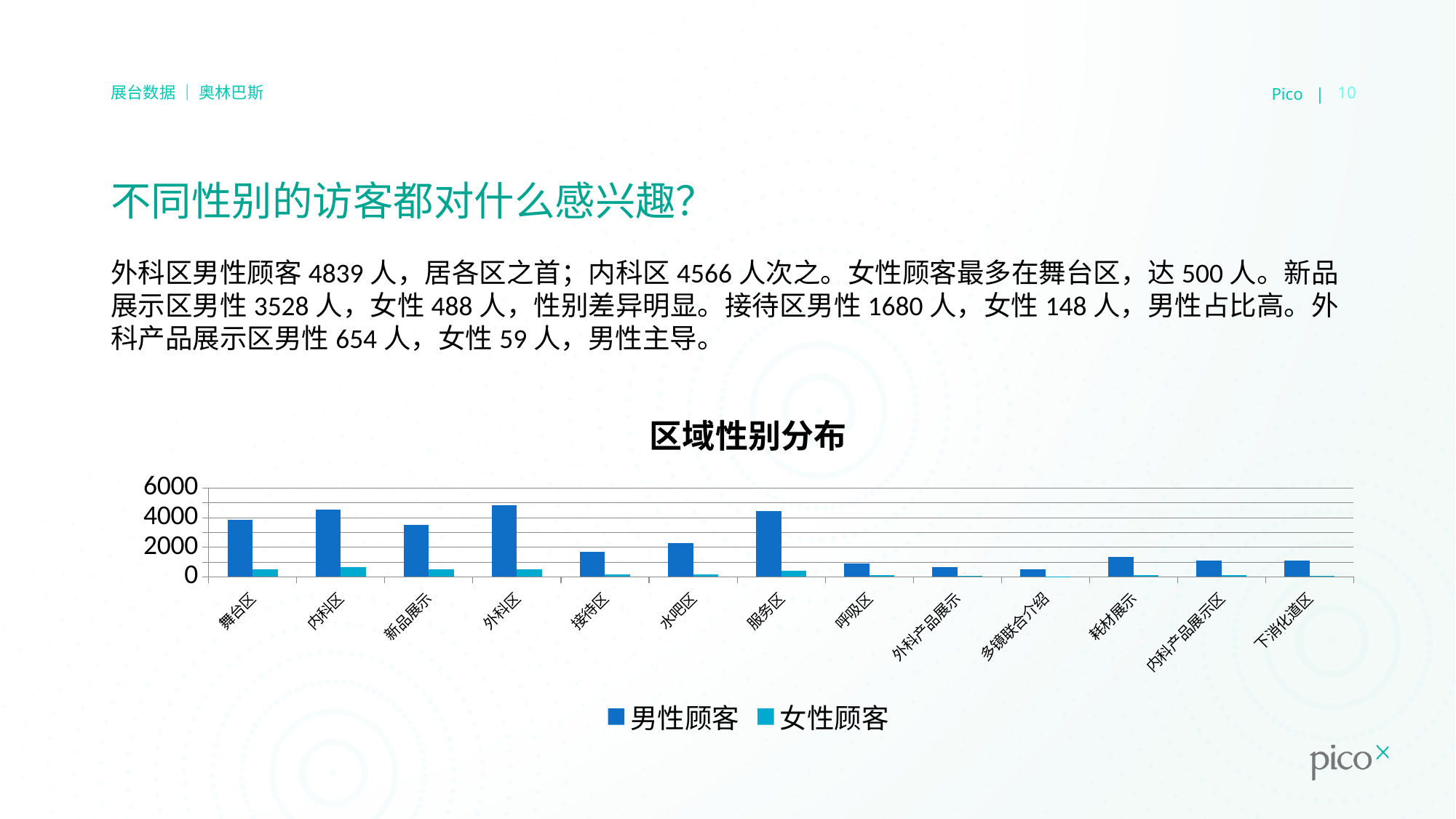
How many series does the legend of the 区域性别分布 chart list? 2 What is the number of 女性顾客 for 舞台区? 500 Which area has the highest number of 男性顾客? 外科区 What is the difference between the 男性顾客 values of 外科区 and 内科区? 273 Is the 男性顾客 value for 耗材展示 greater or less than 2000? less Is the 男性顾客 value for 服务区 greater or less than 4000? greater What kind of chart is shown on the slide? bar chart What is the title of the chart on the slide? 区域性别分布 How many categories (areas) are shown on the x axis of the 区域性别分布 chart? 13 What is the number of 男性顾客 for 内科区? 4566 Which has more 男性顾客, 舞台区 or 内科区? 内科区 What is the difference between 男性顾客 and 女性顾客 in 新品展示? 3040